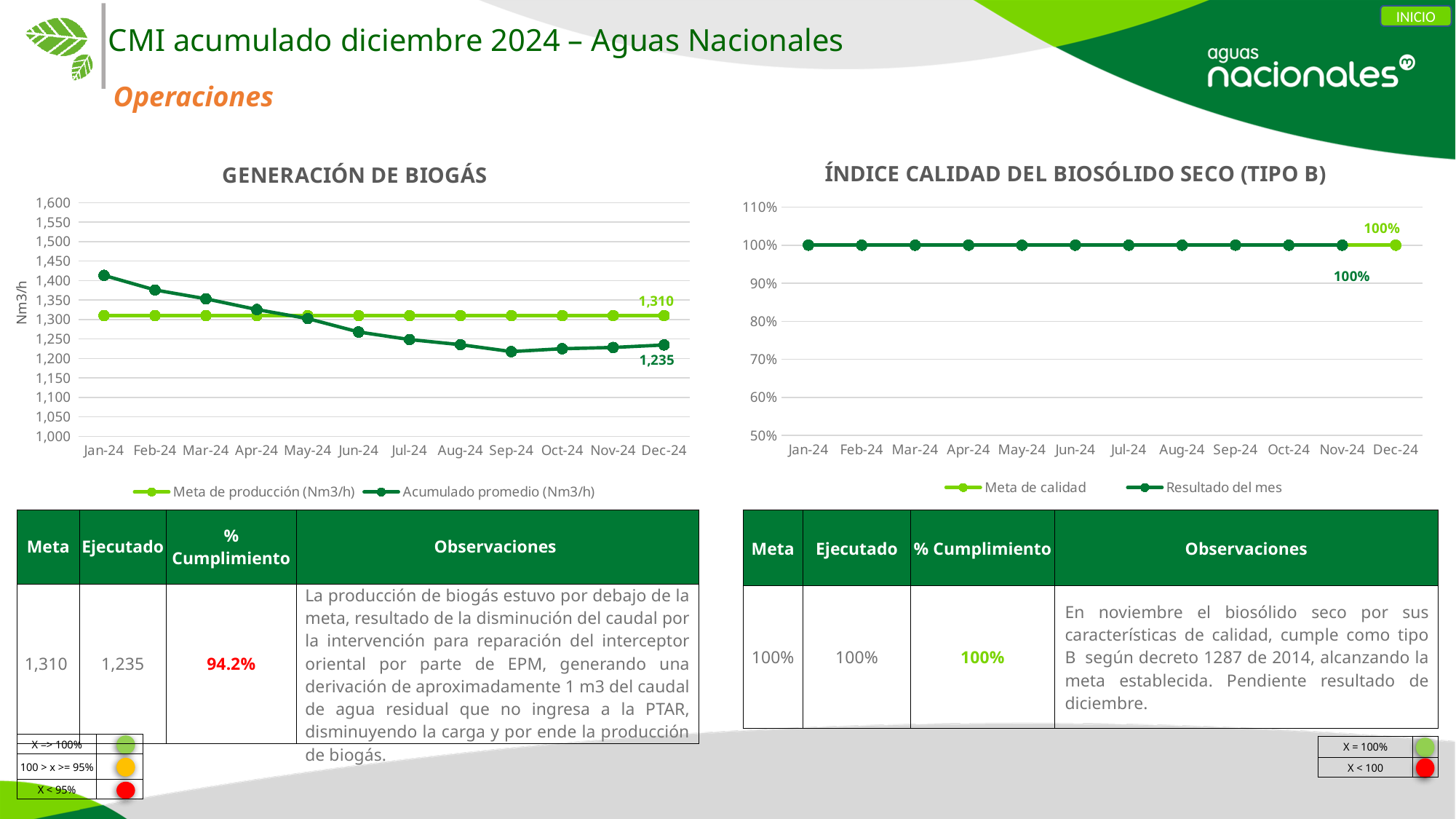
How many series does the legend of the 'ÍNDICE CALIDAD DEL BIOSÓLIDO SECO (TIPO B)' chart list? 2 In the 'GENERACIÓN DE BIOGÁS' chart, is the 'Acumulado promedio (Nm3/h)' value for Jan-24 greater or less than 1,400? greater How many months are plotted on the x axis of the 'ÍNDICE CALIDAD DEL BIOSÓLIDO SECO (TIPO B)' chart? 12 In the 'GENERACIÓN DE BIOGÁS' chart, which month has the highest 'Acumulado promedio (Nm3/h)' value? Jan-24 In the 'GENERACIÓN DE BIOGÁS' chart, what is the difference between the Dec-24 'Meta de producción' value and the Dec-24 'Acumulado promedio' value? 75 In the 'GENERACIÓN DE BIOGÁS' chart, is the 'Acumulado promedio (Nm3/h)' value for Sep-24 greater or less than 1,250? less In the 'GENERACIÓN DE BIOGÁS' chart, which month has the lowest 'Acumulado promedio (Nm3/h)' value? Sep-24 In the 'GENERACIÓN DE BIOGÁS' chart, what is the labelled value of 'Meta de producción (Nm3/h)' for Dec-24? 1,310 In the 'GENERACIÓN DE BIOGÁS' chart, does the 'Acumulado promedio (Nm3/h)' series generally rise or fall from Jan-24 to Sep-24? fall What type of chart is the 'ÍNDICE CALIDAD DEL BIOSÓLIDO SECO (TIPO B)' chart? line chart In the 'GENERACIÓN DE BIOGÁS' chart, which is larger in Feb-24: 'Meta de producción' or 'Acumulado promedio'? Acumulado promedio In the 'GENERACIÓN DE BIOGÁS' chart, what is the labelled value of 'Acumulado promedio (Nm3/h)' for Dec-24? 1,235